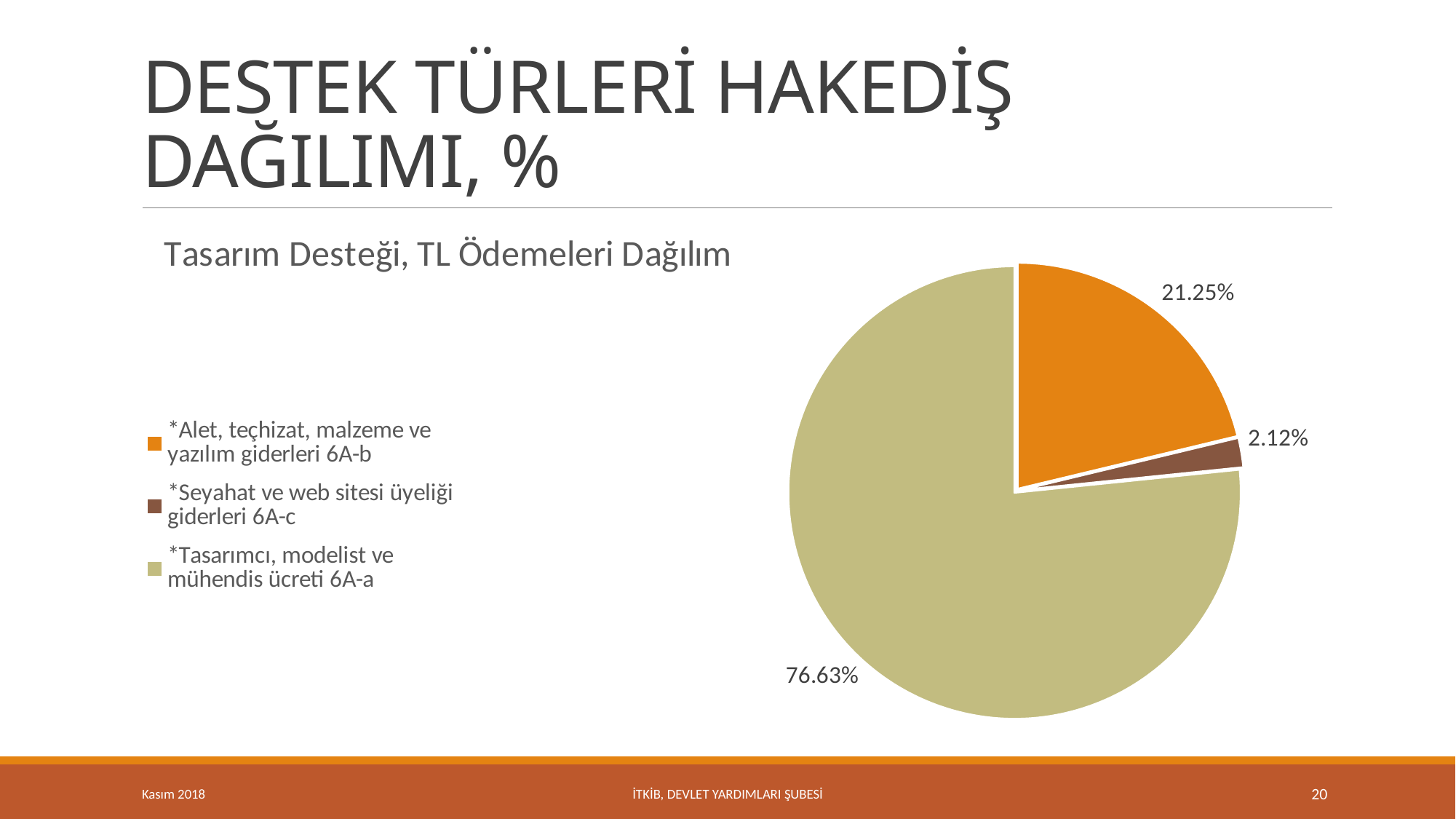
Which is larger: the share of *Alet, teçhizat, malzeme ve yazılım giderleri 6A-b or *Seyahat ve web sitesi üyeliği giderleri 6A-c? *Alet, teçhizat, malzeme ve yazılım giderleri 6A-b What share of the pie is *Alet, teçhizat, malzeme ve yazılım giderleri 6A-b? 21.25% What share of the pie is *Seyahat ve web sitesi üyeliği giderleri 6A-c? 2.12% What is the difference between the shares of *Tasarımcı, modelist ve mühendis ücreti 6A-a and *Alet, teçhizat, malzeme ve yazılım giderleri 6A-b? 55.38% Which category has the smallest slice of the pie? *Seyahat ve web sitesi üyeliği giderleri 6A-c What is the difference between the shares of *Alet, teçhizat, malzeme ve yazılım giderleri 6A-b and *Seyahat ve web sitesi üyeliği giderleri 6A-c? 19.13% What is the chart's title? Tasarım Desteği, TL Ödemeleri Dağılım What kind of chart is shown on the slide? pie chart How many slices does the pie chart have? 3 Which category has the largest slice of the pie? *Tasarımcı, modelist ve mühendis ücreti 6A-a What share of the pie is *Tasarımcı, modelist ve mühendis ücreti 6A-a? 76.63% What colour is the slice for *Seyahat ve web sitesi üyeliği giderleri 6A-c? brown